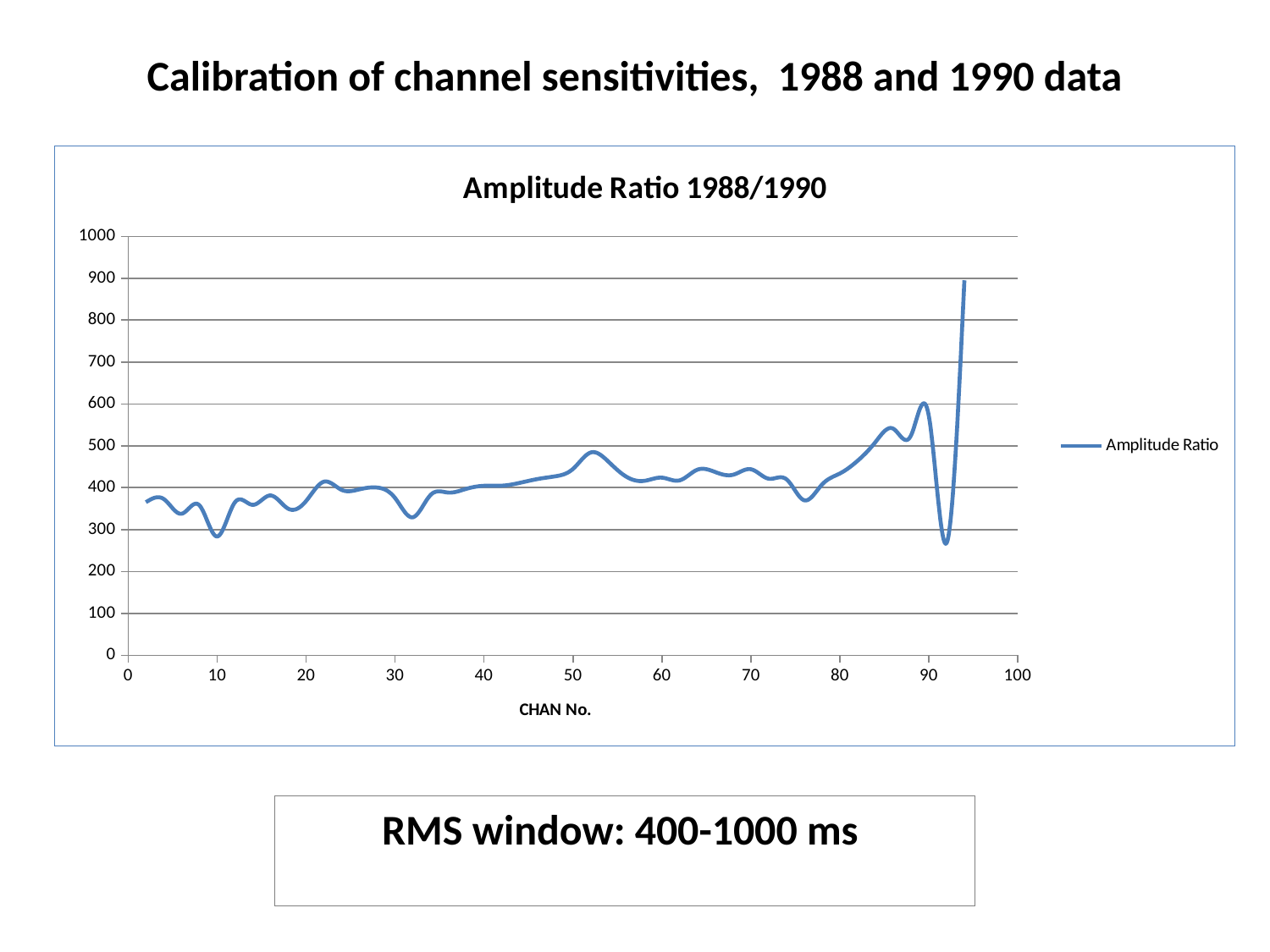
What is the title of the chart? Amplitude Ratio 1988/1990 Is the Amplitude Ratio value at channel 94 greater or less than 800? greater Is the Amplitude Ratio value at channel 60 greater or less than 300? greater Is the Amplitude Ratio value at channel 92 greater or less than 400? less What is the label of the x axis? CHAN No. Between channel 90 and channel 94, does the Amplitude Ratio line end higher or lower than it starts? higher What kind of chart is shown on the slide? line chart Which has the larger Amplitude Ratio value, channel 94 or channel 92? channel 94 Which has the larger Amplitude Ratio value, channel 85 or channel 20? channel 85 How many series does the legend list? 1